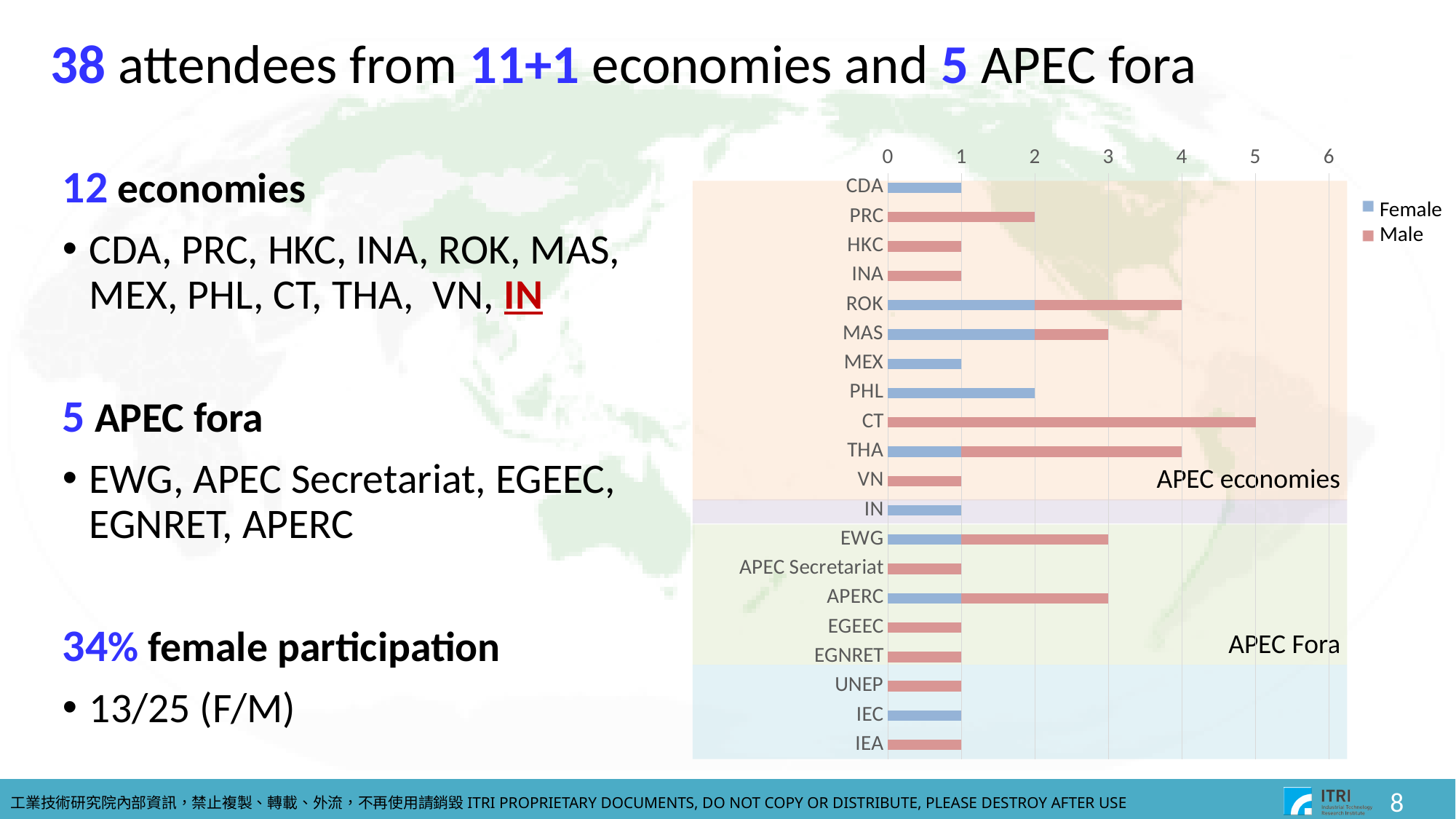
What is the difference between the Male value for CT and the Male value for THA? 2 Which has a longer total bar, MAS or PHL? MAS How many series does the chart legend list? 2 How many categories are plotted on the chart's vertical axis? 20 What is the Male value for PRC? 2 Which category has the longest bar in the chart? CT What is the Female value for PHL? 2 What is the Male value for CT? 5 What is the total length of the stacked bar for ROK? 4 What kind of chart is shown on the slide? bar chart Which series is shown in blue in the legend? Female What is the total length of the stacked bar for THA? 4